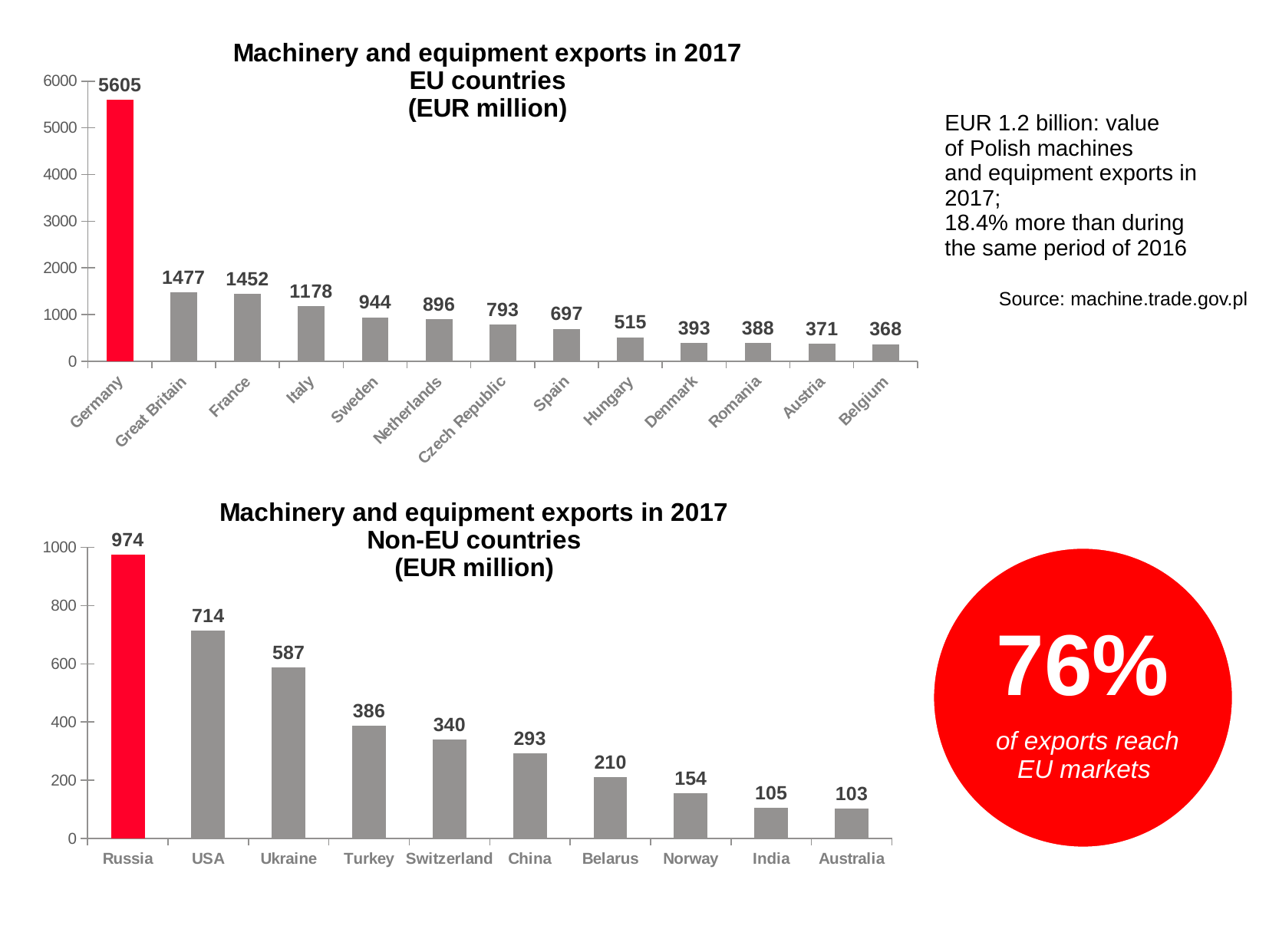
In the Non-EU countries chart, which country has the highest value? Russia In the Non-EU countries chart, how many countries are shown? 10 In the EU countries chart, which is larger, Sweden or Netherlands? Sweden In the EU countries chart, how many countries are shown? 13 What kind of chart is the Non-EU countries chart? Bar chart In the Non-EU countries chart, what is the difference between Russia and USA? 260 In the EU countries chart, what is the difference between Great Britain and France? 25 In the Non-EU countries chart, do the values rise or fall from left to right? Fall In the Non-EU countries chart, what is the value for Ukraine? 587 In the EU countries chart, which country has the lowest value? Belgium In the EU countries chart, what is the value for Germany? 5605 In the EU countries chart, what is the value for Czech Republic? 793